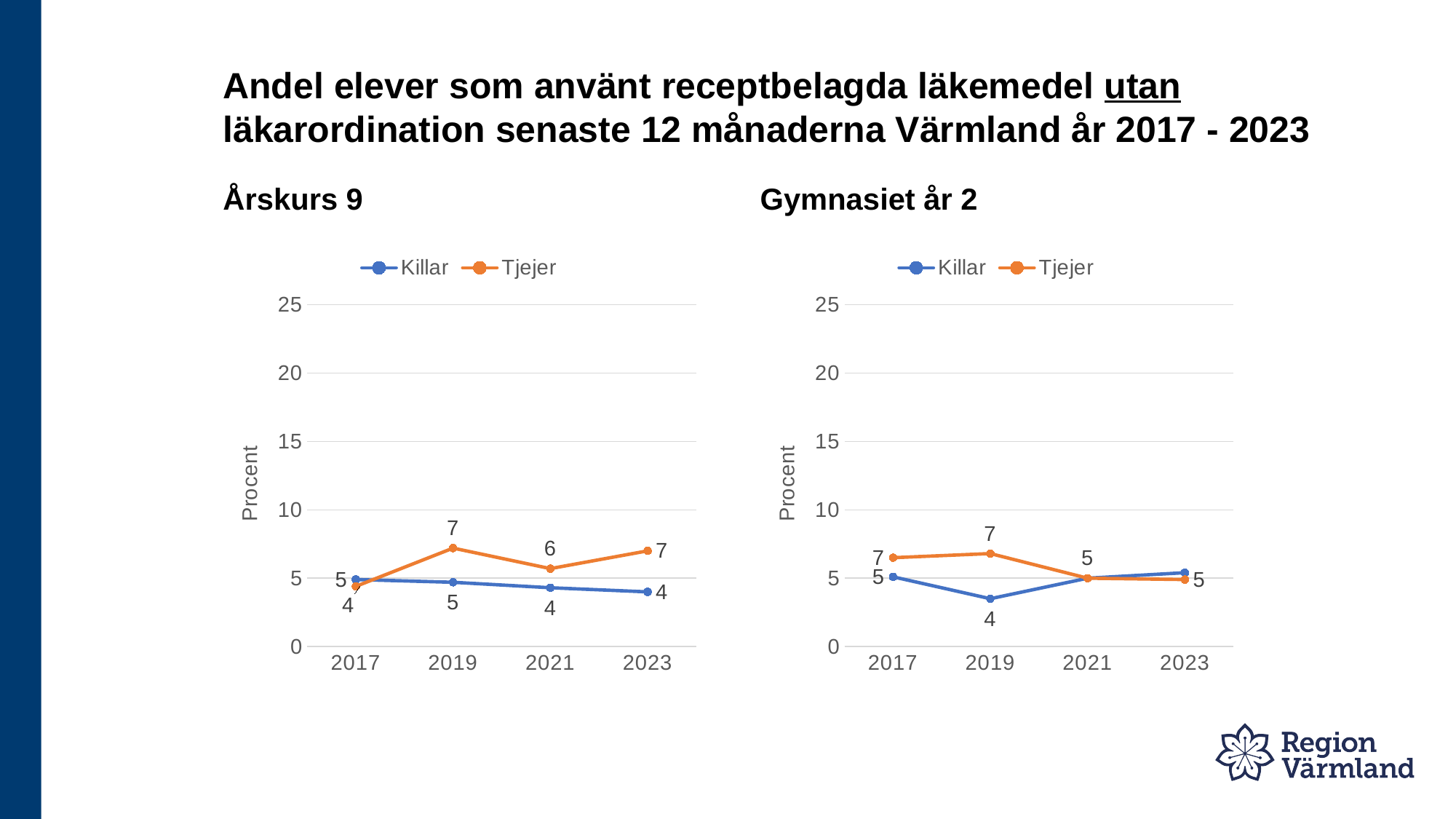
How many series does the legend of the Gymnasiet år 2 chart list? 2 In the Årskurs 9 chart, what is the value for Tjejer in 2017? 4 In the Årskurs 9 chart, what is the value for Tjejer in 2019? 7 In the Gymnasiet år 2 chart, which series has the higher value in 2019, Killar or Tjejer? Tjejer In the Gymnasiet år 2 chart, what is the value for Killar in 2019? 4 In the Gymnasiet år 2 chart, is the value for Tjejer in 2019 greater or less than 10? less In the Årskurs 9 chart, in which year is the Tjejer value lowest? 2017 In the Årskurs 9 chart, what is the difference between Tjejer and Killar in 2023? 3 In the Årskurs 9 chart, what is the value for Killar in 2021? 4 In the Gymnasiet år 2 chart, what is the value for Tjejer in 2017? 7 What kind of chart is the Årskurs 9 chart? line chart In the Årskurs 9 chart, does the Killar line rise or fall from 2017 to 2023? fall